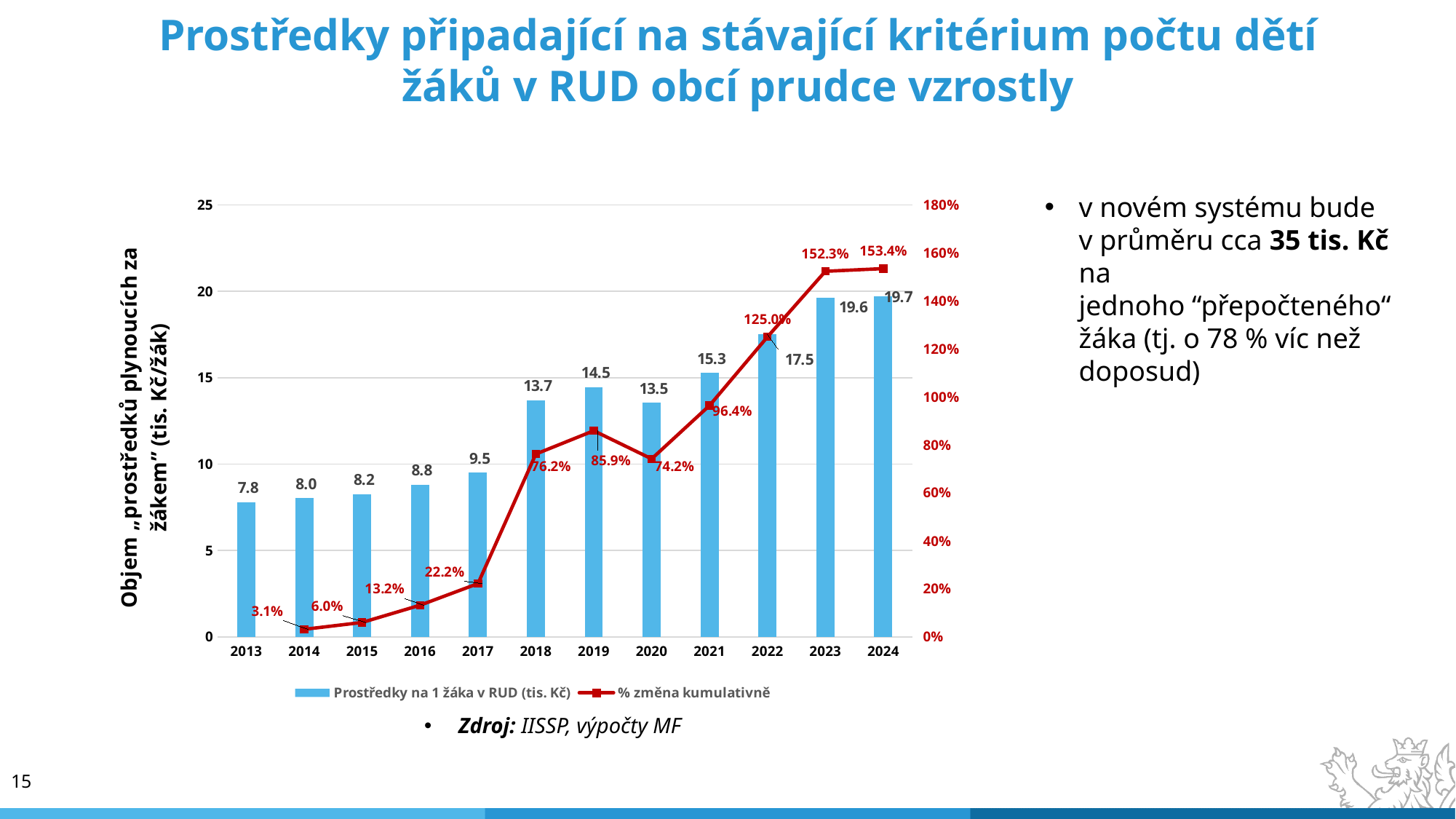
Is the Prostředky na 1 žáka v RUD value for 2017 greater or less than 10? less What is the % změna kumulativně value for 2020? 74.2% Which year has the highest % změna kumulativně value? 2024 What is the % změna kumulativně value for 2022? 125.0% How many series does the chart legend list? 2 Which year has a larger Prostředky na 1 žáka v RUD value, 2019 or 2020? 2019 What is the difference between the Prostředky na 1 žáka v RUD values for 2024 and 2013? 11.9 Do the Prostředky na 1 žáka v RUD values generally rise or fall from 2013 to 2024? Rise What kind of chart is shown on the slide? Combination bar and line chart Which year has the lowest value of Prostředky na 1 žáka v RUD (tis. Kč)? 2013 What is the value of Prostředky na 1 žáka v RUD (tis. Kč) for 2018? 13.7 How many years are shown on the x axis of the chart? 12